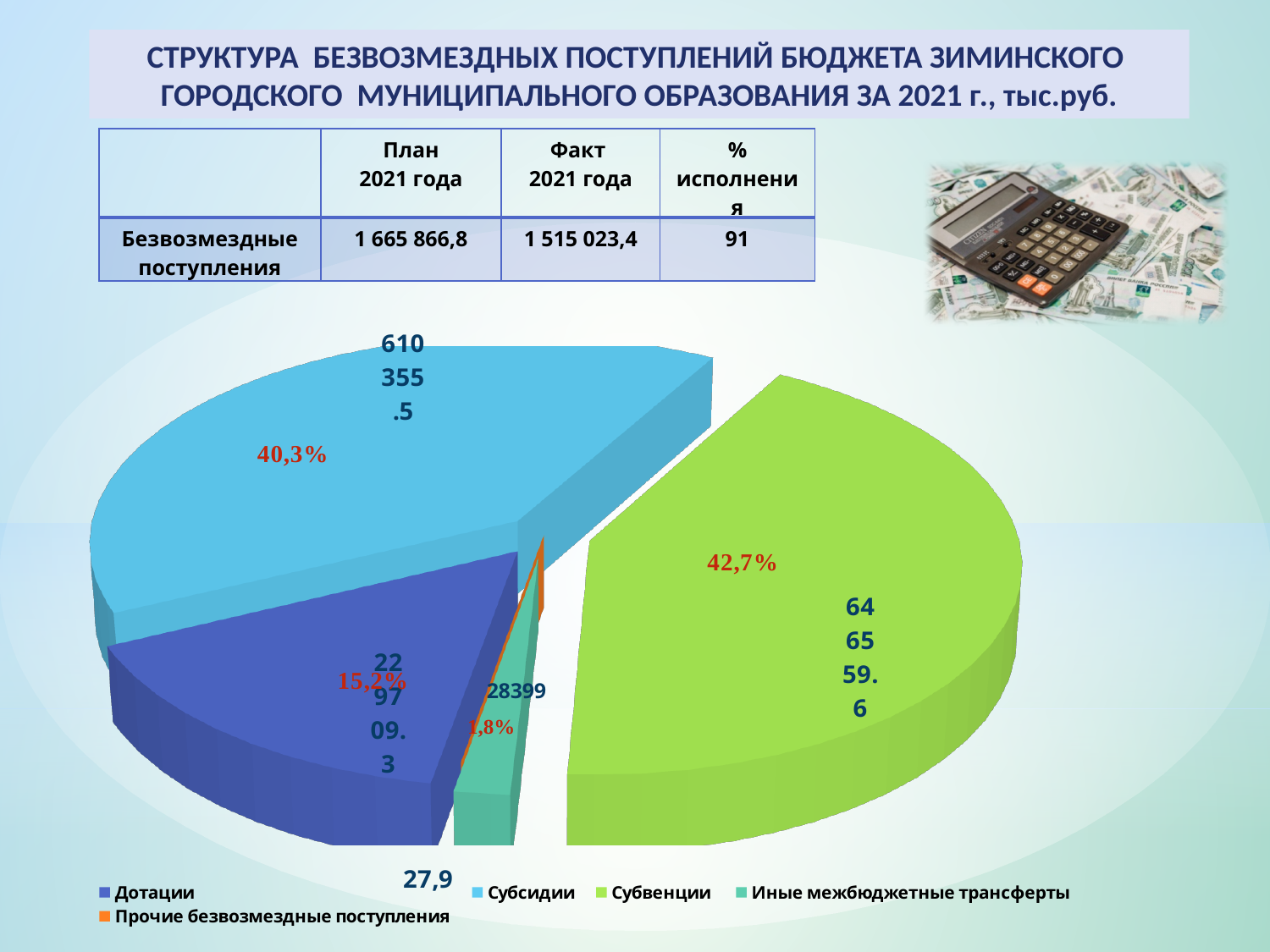
Which category has the smallest slice of the pie chart? Прочие безвозмездные поступления What kind of chart is shown on the slide? pie chart Which slice is larger, Субсидии or Дотации? Субсидии What share of the pie does Субвенции account for? 42,7% What is the difference in percentage points between the shares of Субвенции and Субсидии? 2,4 What share of the pie does Иные межбюджетные трансферты account for? 1,8% How many categories does the legend of the pie chart list? 5 Which category has the largest slice of the pie chart? Субвенции What share of the pie does Субсидии account for? 40,3% Which colour represents Субвенции in the pie chart? green What value is labelled on the Иные межбюджетные трансферты slice? 28399